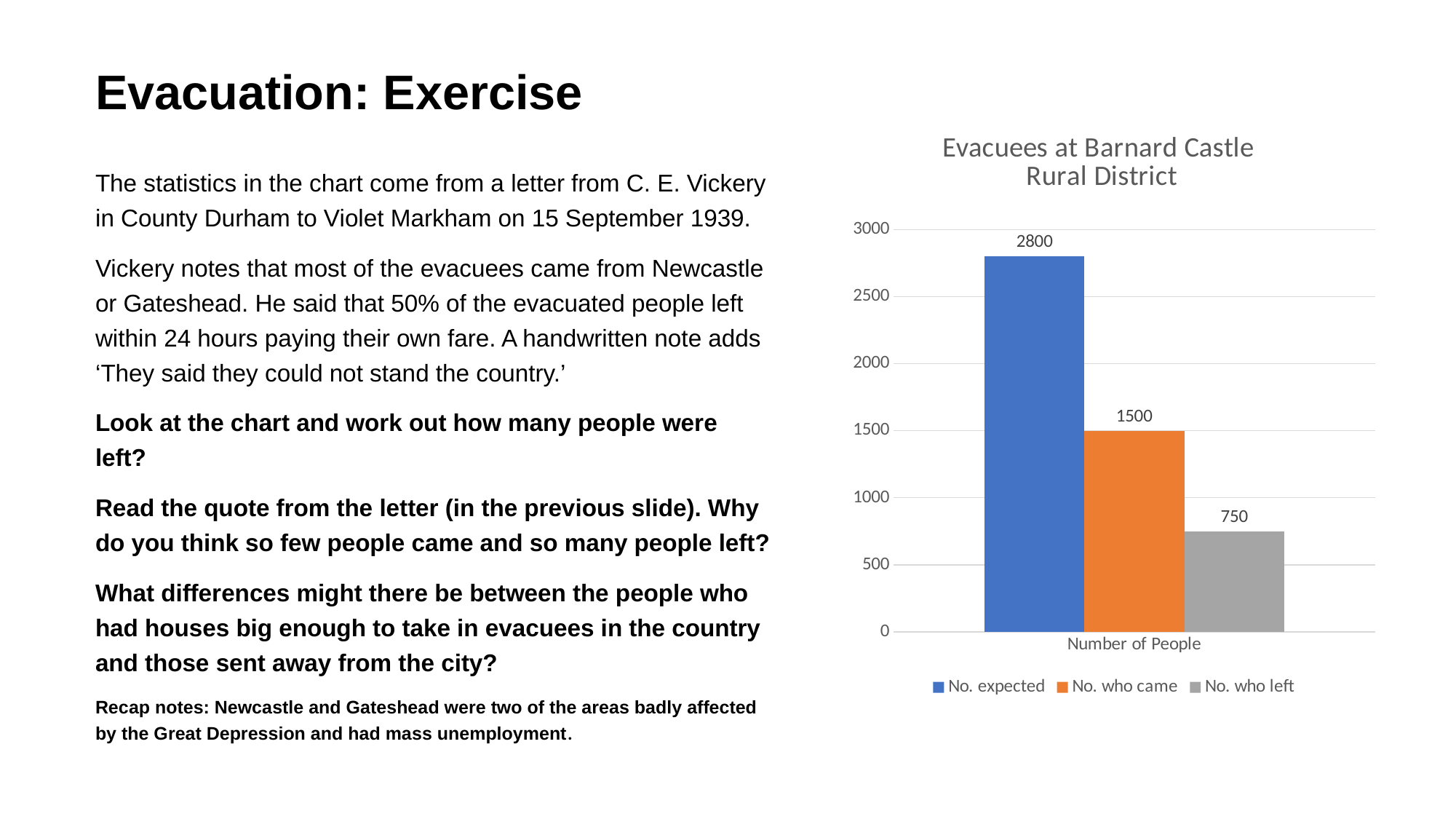
How many series does the legend list? 3 What is the difference between No. expected and No. who came? 1300 What is the title of the chart? Evacuees at Barnard Castle Rural District Which is larger, No. who came or No. who left? No. who came What kind of chart is shown? Bar chart What is the value for No. who left? 750 Which series has the lowest value? No. who left What is the value for No. who came? 1500 Is the value for No. expected greater or less than 2500? greater What is the value for No. expected? 2800 Which series has the highest value? No. expected What is the difference between No. who came and No. who left? 750